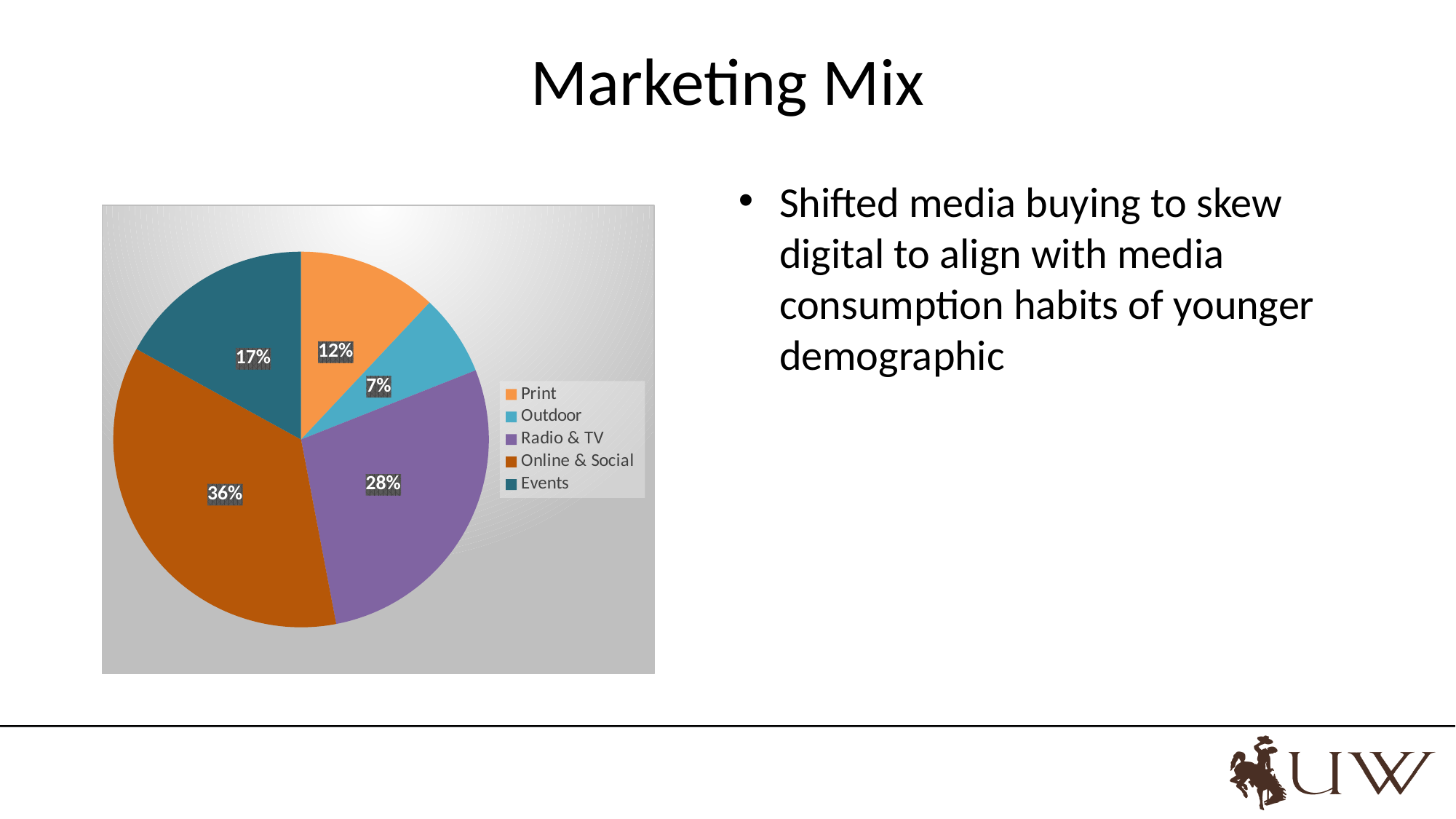
What share of the pie does Print have? 12% Which category has the largest slice of the pie? Online & Social What colour is the Radio & TV slice in the pie chart? Purple How many categories does the pie chart have? 5 Which is larger, the Events share or the Print share? Events What share of the pie does Outdoor have? 7% What kind of chart is shown on the slide? Pie chart Which category has the smallest slice of the pie? Outdoor What share of the pie does Events have? 17% What is the difference between the Online & Social share and the Radio & TV share? 8%